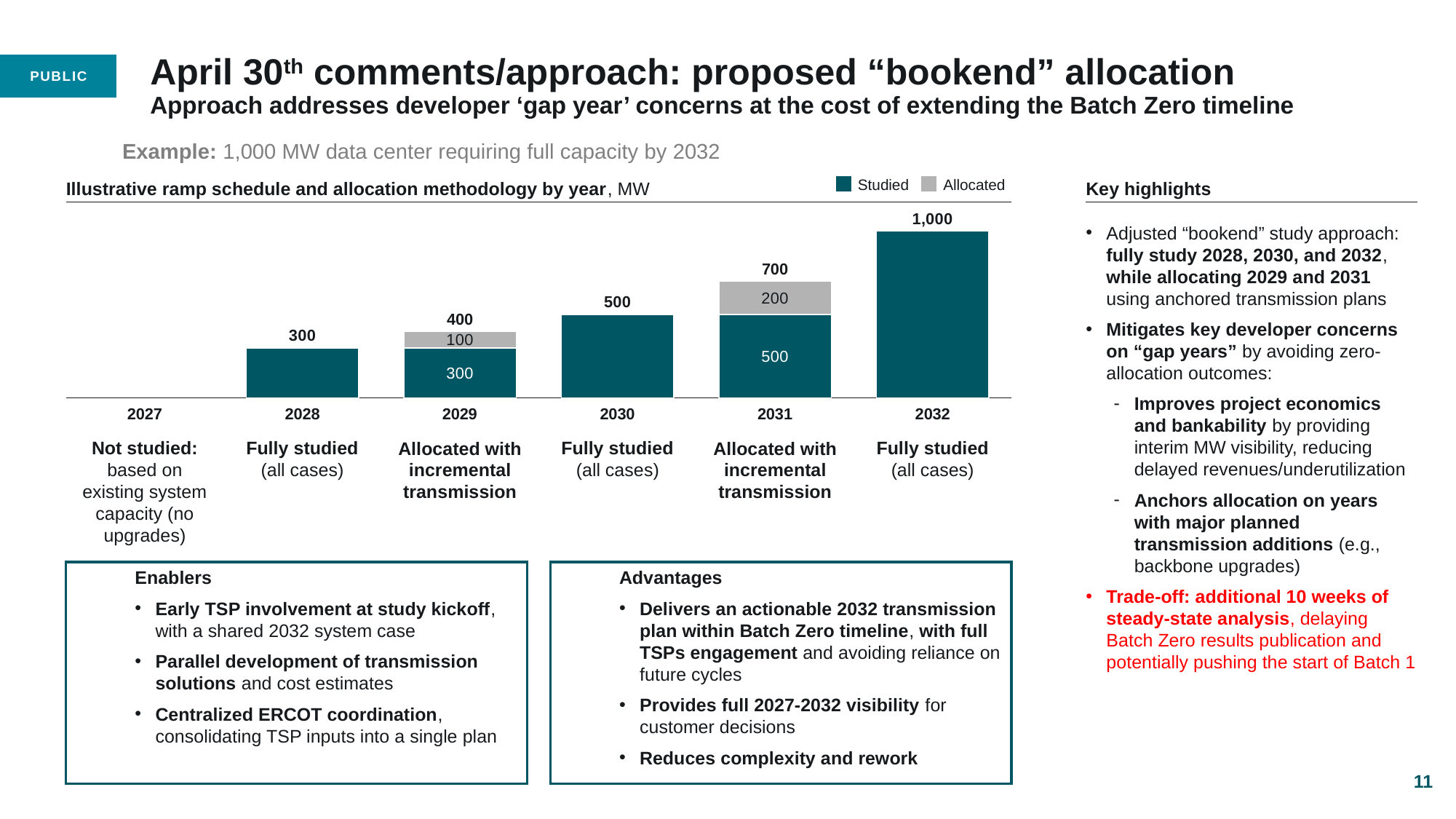
What unit is stated in the chart title? MW Do the total values rise or fall from 2028 to 2032? Rise What is the difference between the total for 2032 and the total for 2031? 300 What is the Allocated value for 2029? 100 What is the total value shown for 2032? 1,000 What is the total value shown above the 2031 bar? 700 What is the Studied value for 2031? 500 Which year has the highest total value? 2032 What is the difference between the Allocated value for 2031 and the Allocated value for 2029? 100 What kind of chart is shown? Stacked bar chart How many series does the legend list? 2 Which is larger, the total for 2030 or the total for 2029? 2030